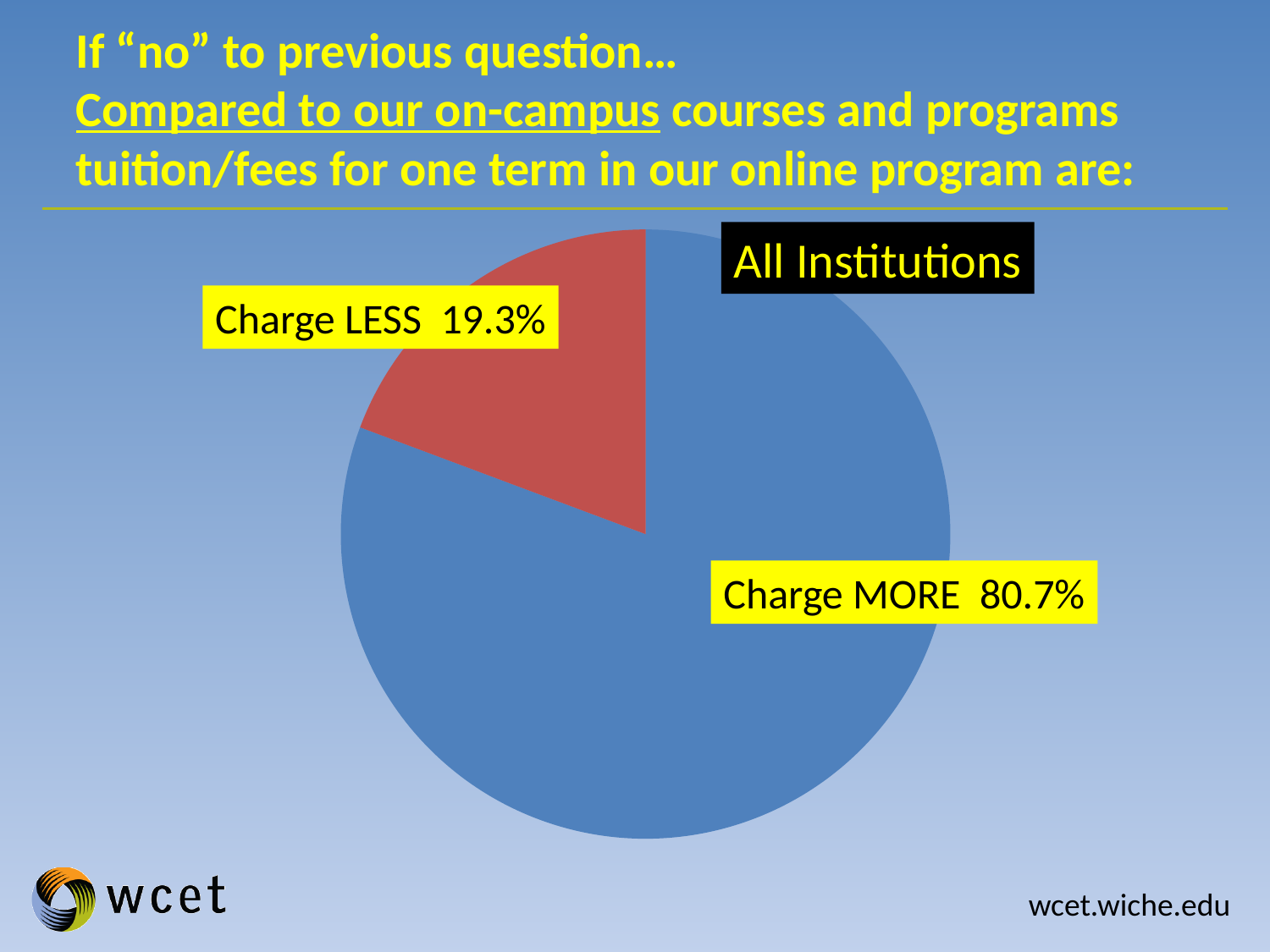
What is the total of the two slice percentages shown? 100% Is the Charge MORE share greater or less than 50%? greater What kind of chart is shown on the slide? pie chart Which category has the largest slice of the pie? Charge MORE Which is larger, the Charge MORE slice or the Charge LESS slice? Charge MORE Which category has the smallest slice of the pie? Charge LESS What is the label shown in the black box on the chart? All Institutions What share of institutions charge LESS for their online program compared to on-campus? 19.3% What colour is the Charge LESS slice? red What is the difference in percentage points between Charge MORE and Charge LESS? 61.4 How many slices does the pie chart have? 2 What share of institutions charge MORE for their online program compared to on-campus? 80.7%